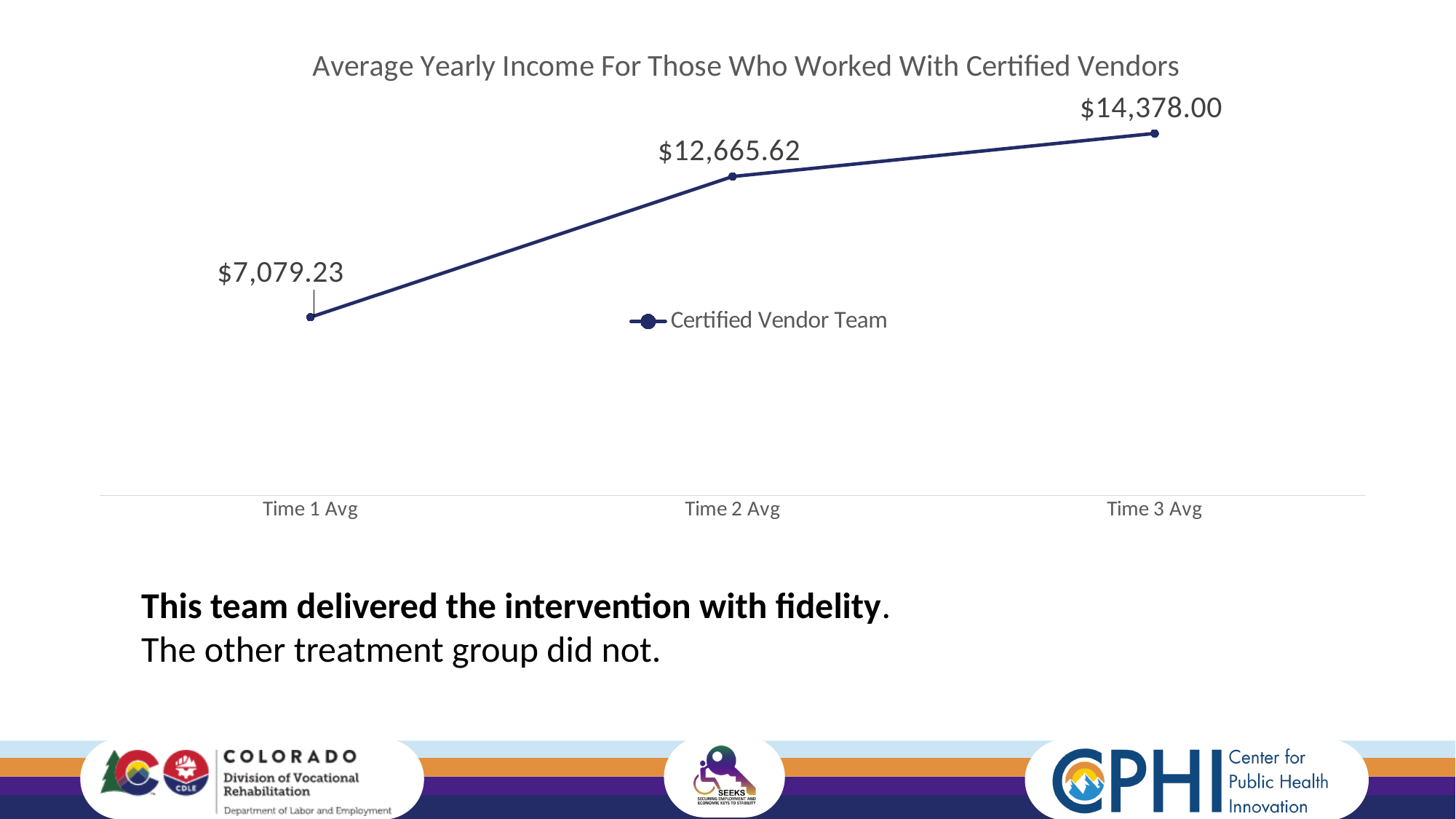
Which is larger, the average yearly income at Time 2 Avg or at Time 3 Avg? Time 3 Avg What is the difference in average yearly income between Time 3 Avg and Time 1 Avg? $7,298.77 What kind of chart is shown on the slide? Line chart What is the average yearly income at Time 2 Avg? $12,665.62 Which time point has the lowest average yearly income? Time 1 Avg What is the average yearly income at Time 3 Avg? $14,378.00 What is the difference in average yearly income between Time 3 Avg and Time 2 Avg? $1,712.38 How many time points are plotted on the chart? 3 What is the average yearly income at Time 1 Avg? $7,079.23 Which time point has the highest average yearly income? Time 3 Avg What is the difference in average yearly income between Time 2 Avg and Time 1 Avg? $5,586.39 Does the average yearly income rise or fall from Time 1 Avg to Time 3 Avg? Rise